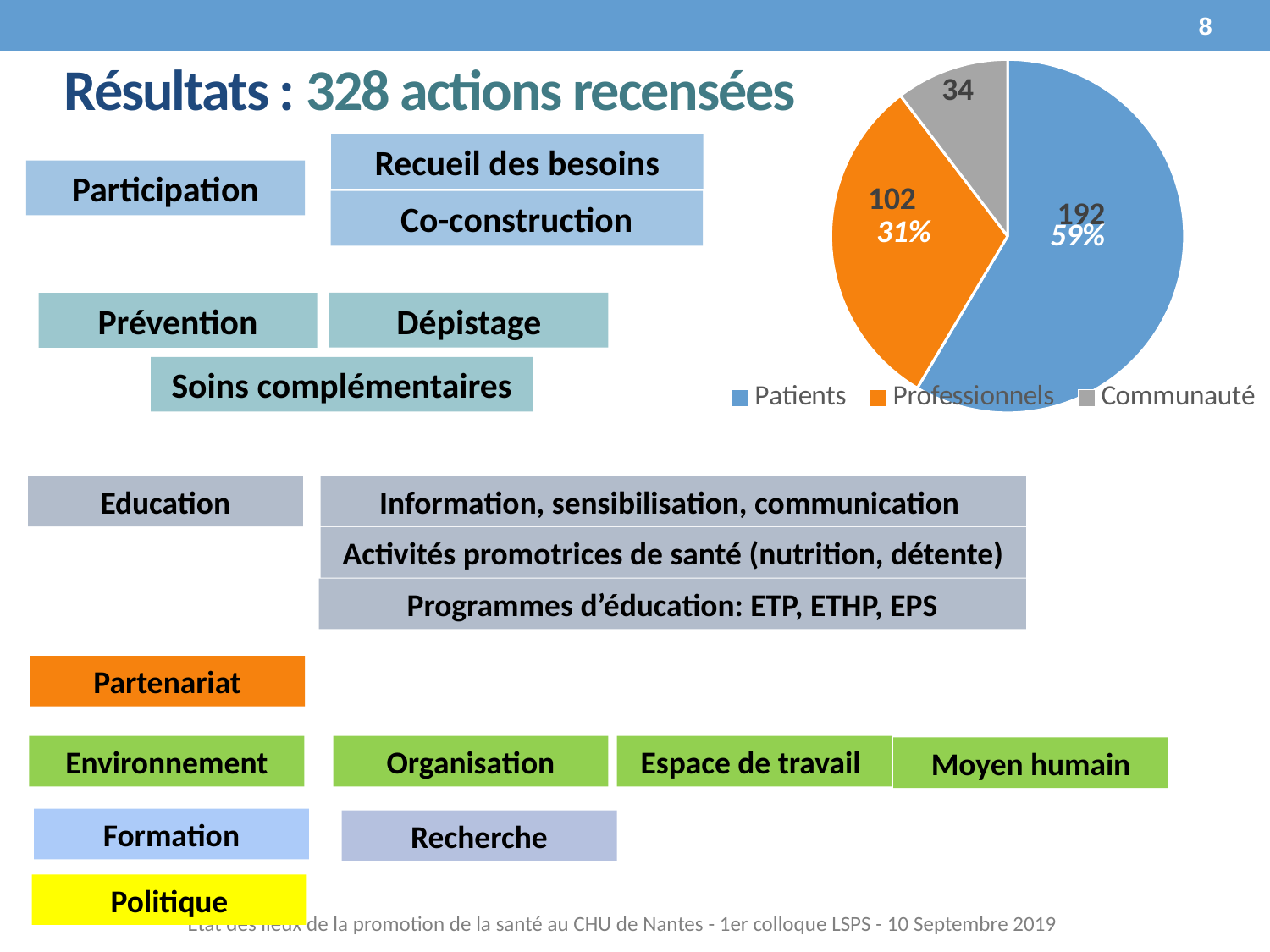
How many entries does the pie chart legend list? 3 What share of the pie does the Patients slice represent? 59% Which is larger, the value for Professionnels or the value for Communauté? Professionnels What is the value for Patients in the pie chart? 192 What is the value for Communauté in the pie chart? 34 What colour is the Professionnels slice in the pie chart? orange Which category has the smallest slice in the pie chart? Communauté What type of chart is shown on the slide? pie chart What is the value for Professionnels in the pie chart? 102 How many slices does the pie chart have? 3 What is the difference between the values for Patients and Professionnels? 90 Which category has the largest slice in the pie chart? Patients